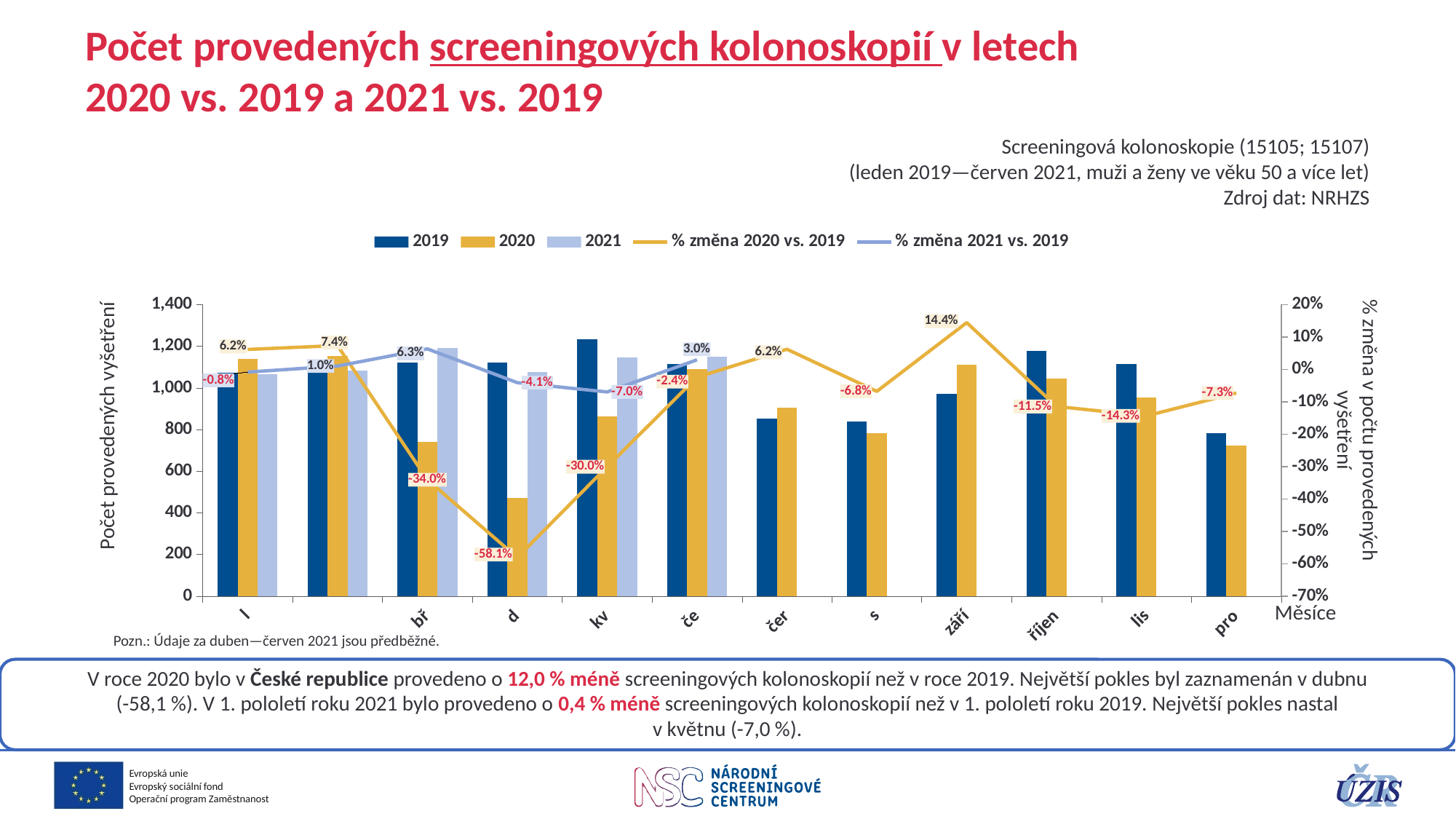
Is the 2020 bar for the month 'd' greater or less than 600? less What kind of chart is shown on the slide? A combined bar and line chart In which month is '% změna 2020 vs. 2019' the highest? září Which is larger: the 2020 bar for 'bř' or the 2020 bar for 'd'? bř In which month is '% změna 2021 vs. 2019' the highest? bř How many series does the legend list? 5 What is the value of '% změna 2020 vs. 2019' for the month 'lis'? -14.3% What is the value of '% změna 2021 vs. 2019' for the month 'kv'? -7.0% How many months (categories) are shown on the x axis? 12 In which month is '% změna 2020 vs. 2019' the lowest? d What is the value of '% změna 2020 vs. 2019' for the month 'd'? -58.1% What is the difference in percentage points between '% změna 2020 vs. 2019' for 'září' and for 'říjen'? 25.9 percentage points